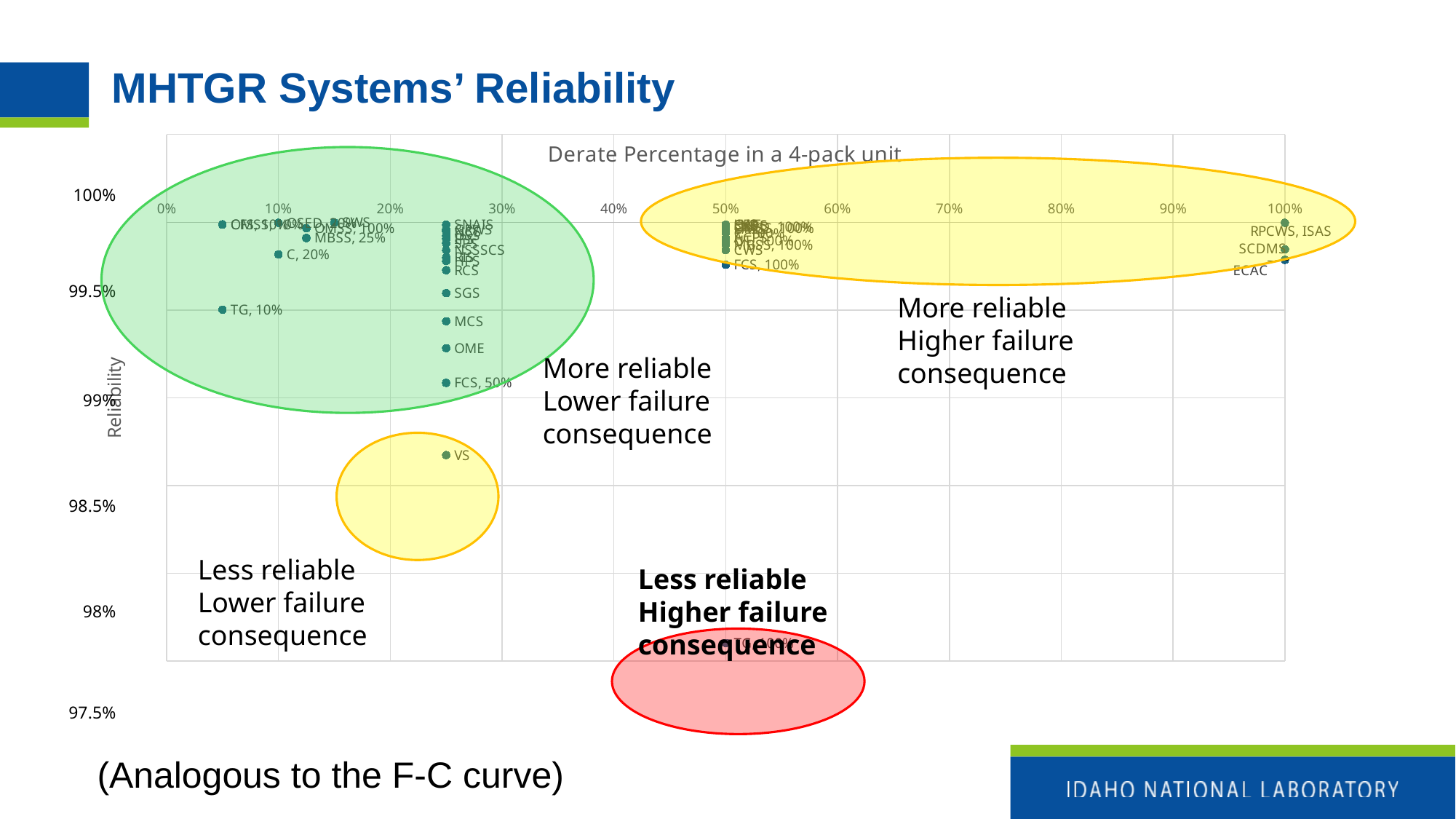
Is the reliability value for TG greater or less than 99.5%? less What is the title shown at the top of the chart? Derate Percentage in a 4-pack unit What is the label on the vertical axis of the chart? Reliability Which has the higher reliability, SGS or OME? SGS Is the reliability value for VS greater or less than 99%? less What derate percentage is shown in the data label for MBSS? 25% What derate percentage is shown in the data label for TG? 10% Among VS, SGS and MCS, which point has the lowest reliability? VS Is the reliability value for the point labelled FCS, 50% greater or less than 99%? greater What derate percentage is shown in the data label for C? 20% What kind of chart is shown on the slide? scatter chart